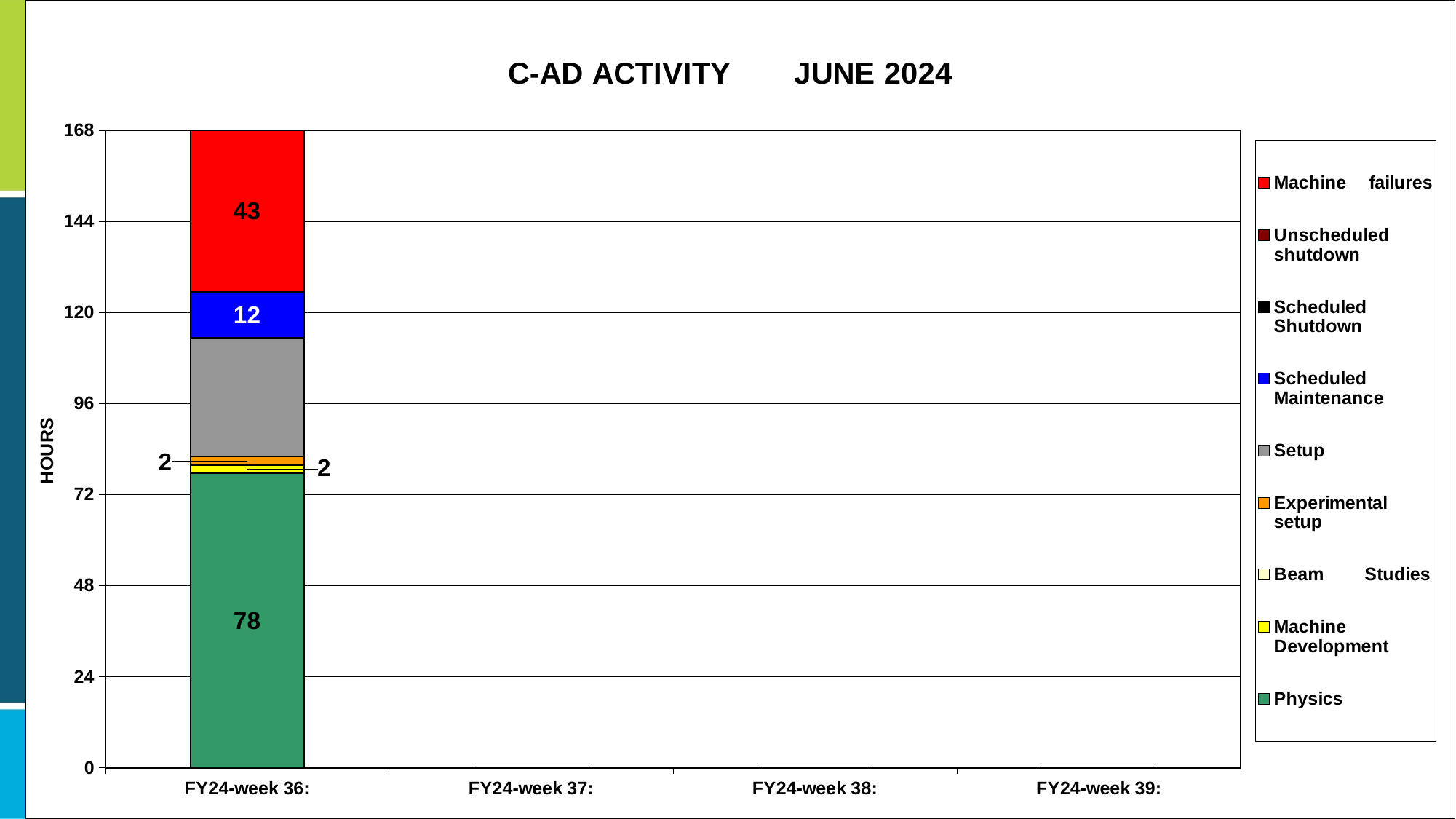
What is the Scheduled Maintenance value for FY24-week 36? 12 What is the difference between the Physics and Machine failures values in FY24-week 36? 35 How many series does the legend list? 9 How many week categories are shown on the x axis? 4 What is the value for Experimental setup in FY24-week 36? 2 In FY24-week 36, which is larger: Machine failures or Scheduled Maintenance? Machine failures What is the total height of the stacked bar for FY24-week 36? 168 What type of chart is shown on the slide? Stacked bar chart What is the value for Physics in FY24-week 36? 78 What is the difference between Machine failures and Scheduled Maintenance in FY24-week 36? 31 How many hours of Machine failures are shown for FY24-week 36? 43 Which series has the largest segment in the FY24-week 36 bar? Physics